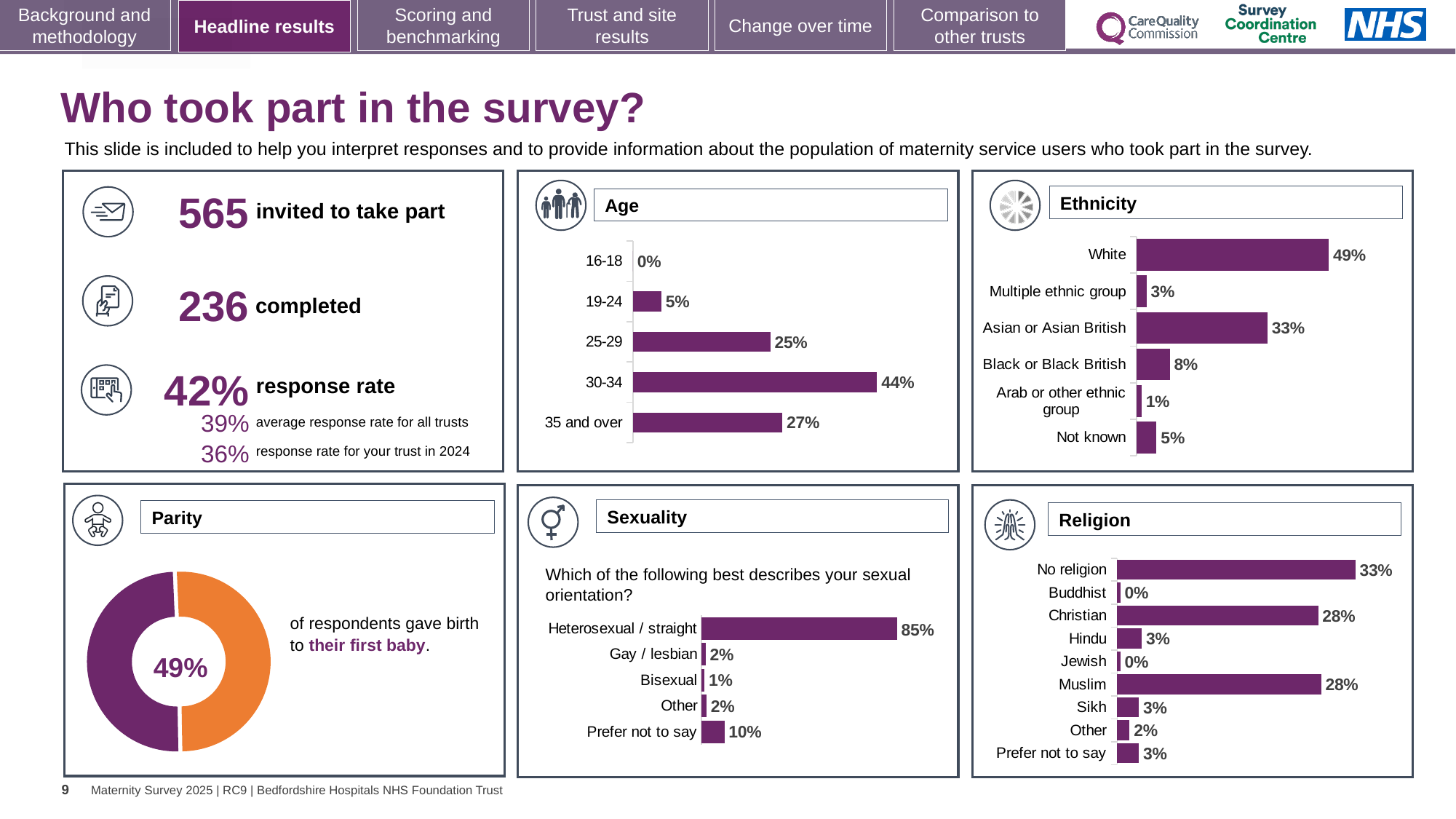
In the Age chart, how many age categories are shown? 5 In the Sexuality chart, which is larger, Gay / lesbian or Bisexual? Gay / lesbian What kind of chart is the Parity chart? Doughnut chart In the Ethnicity chart, what is the difference between the White and Black or Black British percentages? 41% In the Age chart, which age group has the highest percentage? 30-34 In the Ethnicity chart, what percentage of respondents were Asian or Asian British? 33% In the Sexuality chart, what percentage of respondents answered Prefer not to say? 10% In the Religion chart, how many religion categories are shown? 9 In the Parity chart, what share of respondents gave birth to their first baby? 49% In the Age chart, what percentage of respondents were aged 30-34? 44% In the Religion chart, what percentage of respondents were Muslim? 28% In the Ethnicity chart, which category has the lowest percentage? Arab or other ethnic group